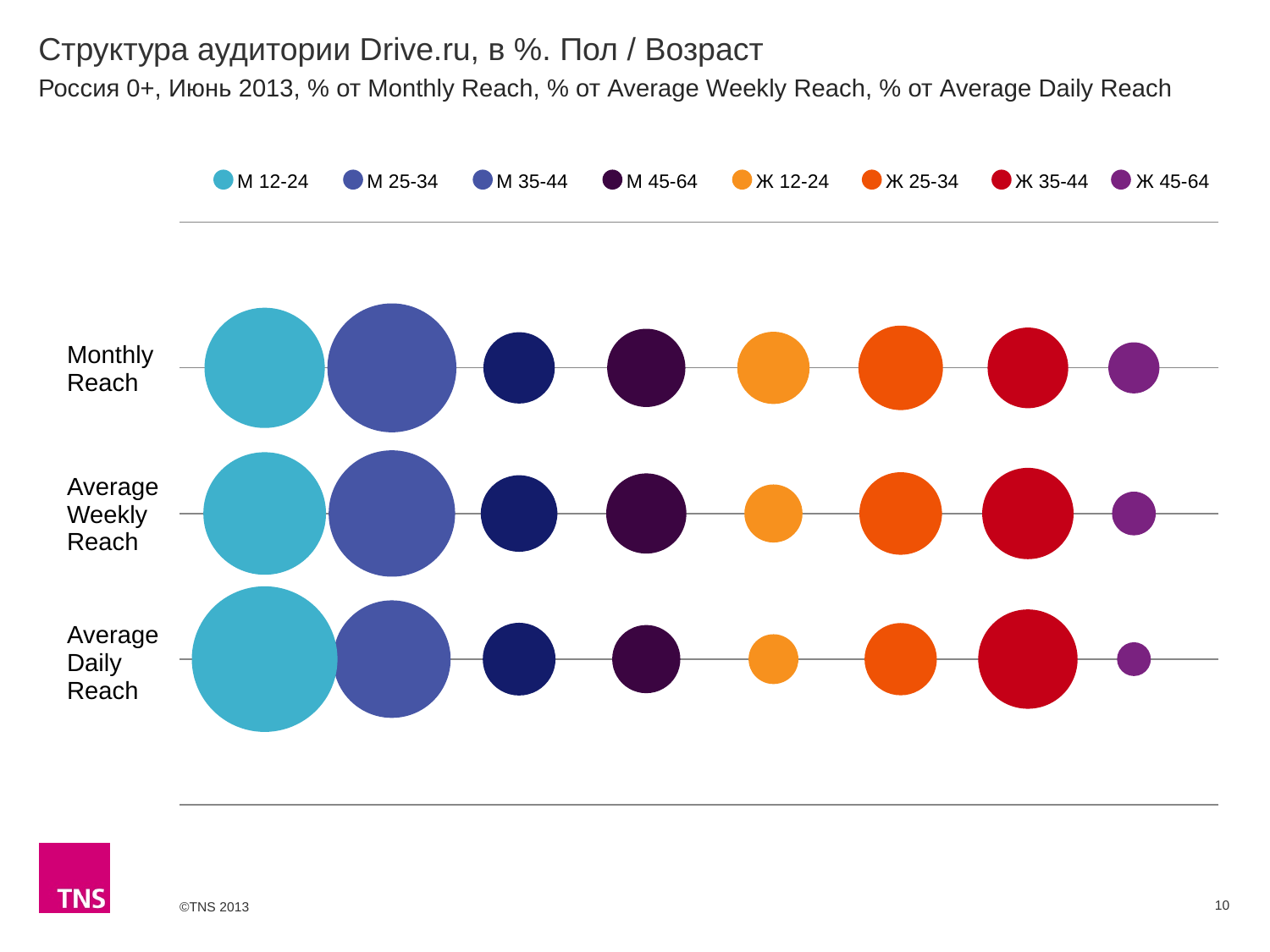
In the Average Daily Reach row, which bubble is larger: Ж 12-24 or Ж 25-34? Ж 25-34 Which series has the smallest bubble in the Monthly Reach row? Ж 45-64 Does the Ж 12-24 bubble grow or shrink going from Monthly Reach to Average Daily Reach? Shrinks In the Monthly Reach row, which bubble is larger: М 25-34 or М 35-44? М 25-34 Does the М 12-24 bubble grow or shrink going from Monthly Reach to Average Daily Reach? Grows What is the title of the chart on the slide? Структура аудитории Drive.ru, в %. Пол / Возраст What kind of chart is shown on the slide? Bubble chart How many reach categories (rows) are plotted on the chart? 3 Which series has the smallest bubble in the Average Daily Reach row? Ж 45-64 In the Average Weekly Reach row, which bubble is larger: Ж 35-44 or Ж 45-64? Ж 35-44 Which series has the largest bubble in the Average Daily Reach row? М 12-24 How many series does the legend list? 8